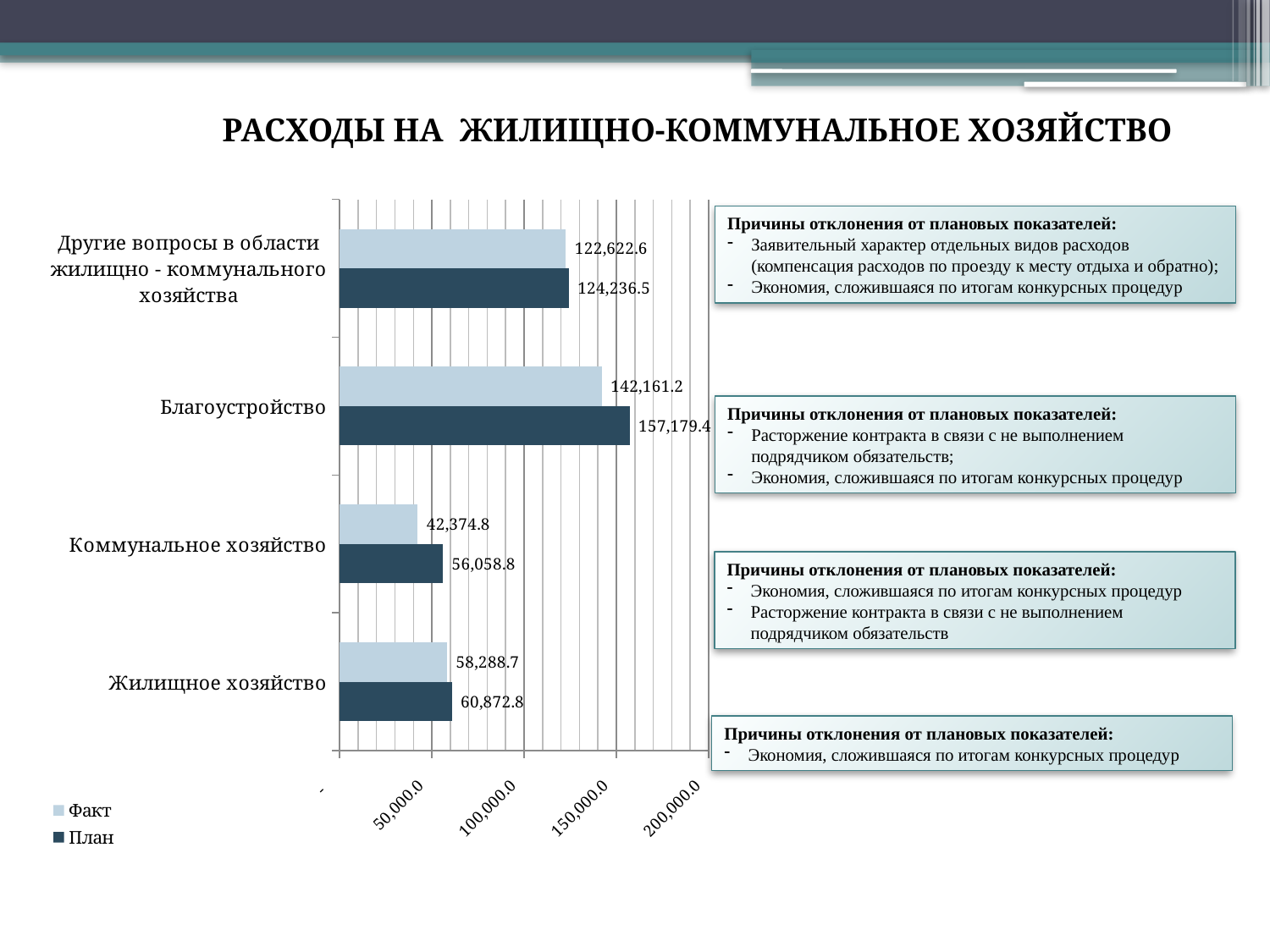
What is the План value for Другие вопросы в области жилищно-коммунального хозяйства? 124,236.5 How many series does the legend list? 2 How many categories are shown on the chart? 4 What is the difference between the План and Факт values for Коммунальное хозяйство? 13,684.0 What is the difference between the План and Факт values for Благоустройство? 15,018.2 What is the Факт value for Жилищное хозяйство? 58,288.7 What type of chart is shown on the slide? Bar chart Which category has the highest План value? Благоустройство Which category has the lowest Факт value? Коммунальное хозяйство Which is larger for Жилищное хозяйство, the Факт value or the План value? План What is the План value for Коммунальное хозяйство? 56,058.8 What is the Факт value for Благоустройство? 142,161.2